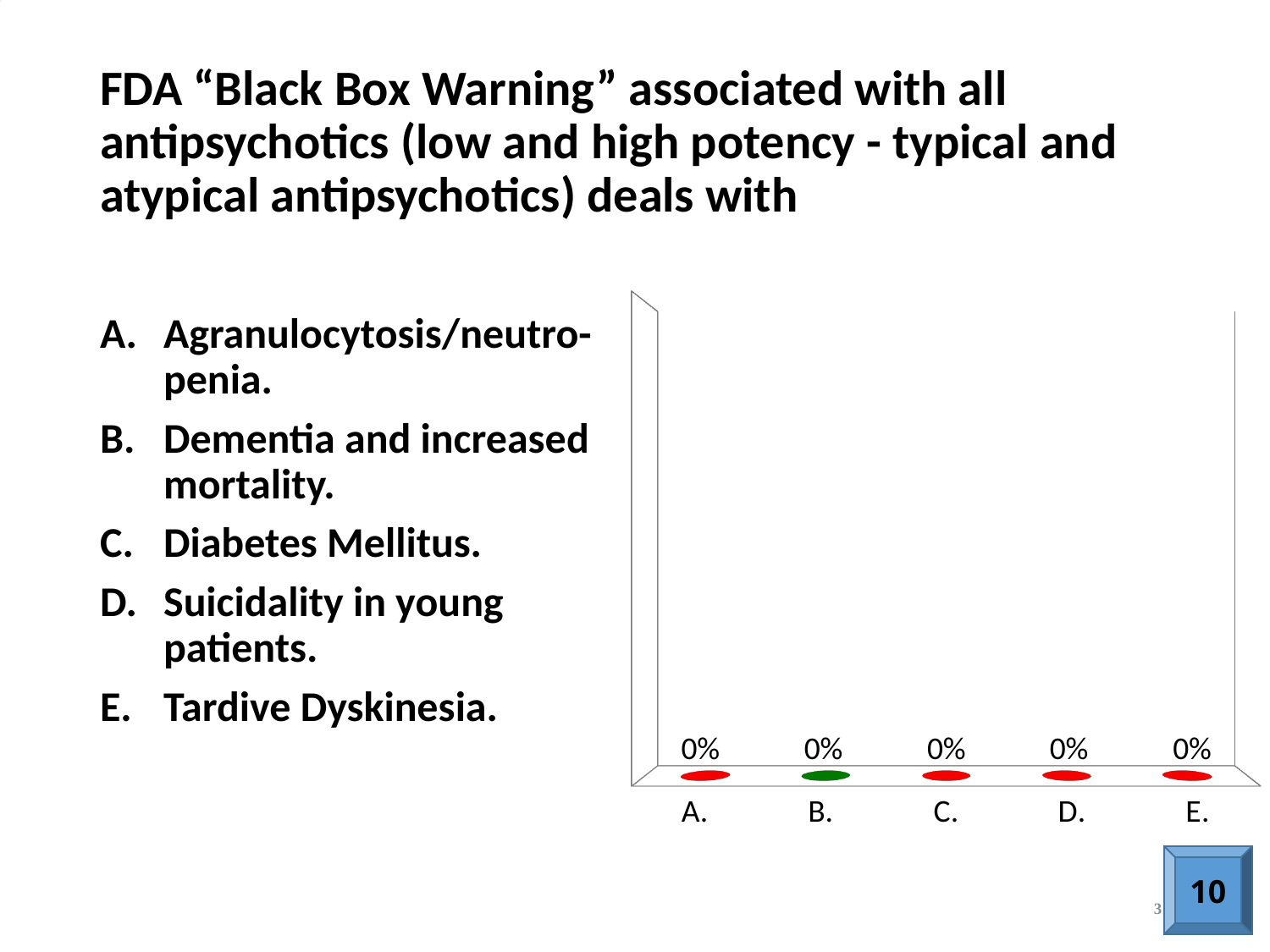
What is the value shown for category E. in the chart? 0% What is the total of all five values shown in the chart? 0% What kind of chart is shown on the slide? bar chart Which category's bar is coloured green rather than red in the chart? B. What is the value shown for category D. in the chart? 0% How many categories are shown on the x axis of the chart? 5 What is the value shown for category B. in the chart? 0% What is the difference between the values for category A. and category E. in the chart? 0% What is the value shown for category A. in the chart? 0% What are the category labels along the x axis of the chart, in order? A., B., C., D., E. What is the value shown for category C. in the chart? 0%